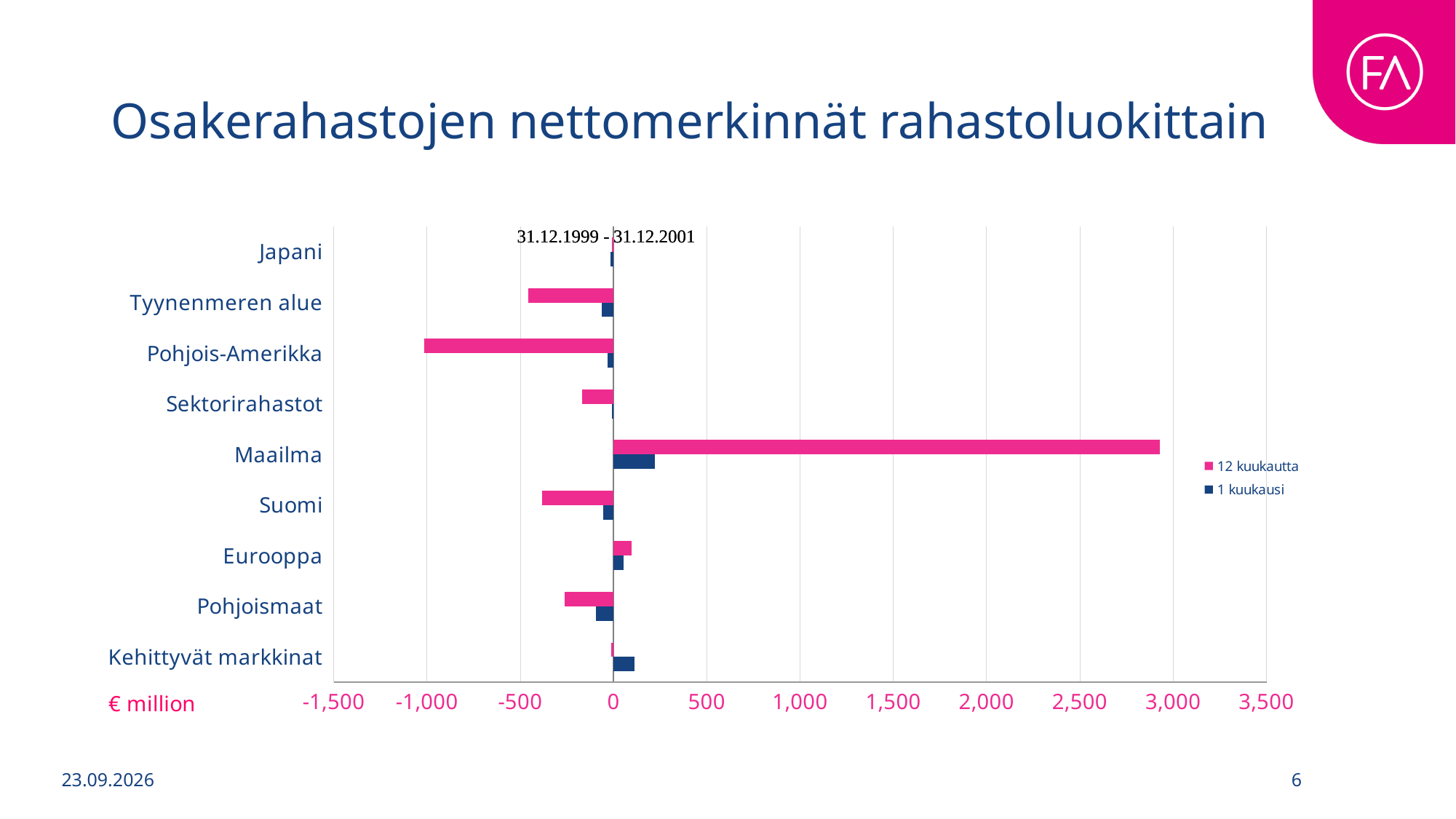
Is the 12 kuukautta value for Maailma greater or less than 2,500? greater Which is larger, the 12 kuukautta value for Maailma or the 12 kuukautta value for Eurooppa? Maailma What unit is shown for the horizontal axis of the chart? € million What is the title of the slide? Osakerahastojen nettomerkinnät rahastoluokittain How many fund categories are listed on the vertical axis of the chart? 9 Which category has the lowest (most negative) value for the 12 kuukautta series? Pohjois-Amerikka How many series does the chart legend list? 2 Is the 12 kuukautta value for Pohjois-Amerikka greater or less than -500? less Is the 12 kuukautta value for Suomi greater or less than 0? less What kind of chart is shown on the slide? bar chart Which is larger, the 1 kuukausi value for Kehittyvät markkinat or the 1 kuukausi value for Pohjoismaat? Kehittyvät markkinat Which category has the highest value for the 12 kuukautta series? Maailma